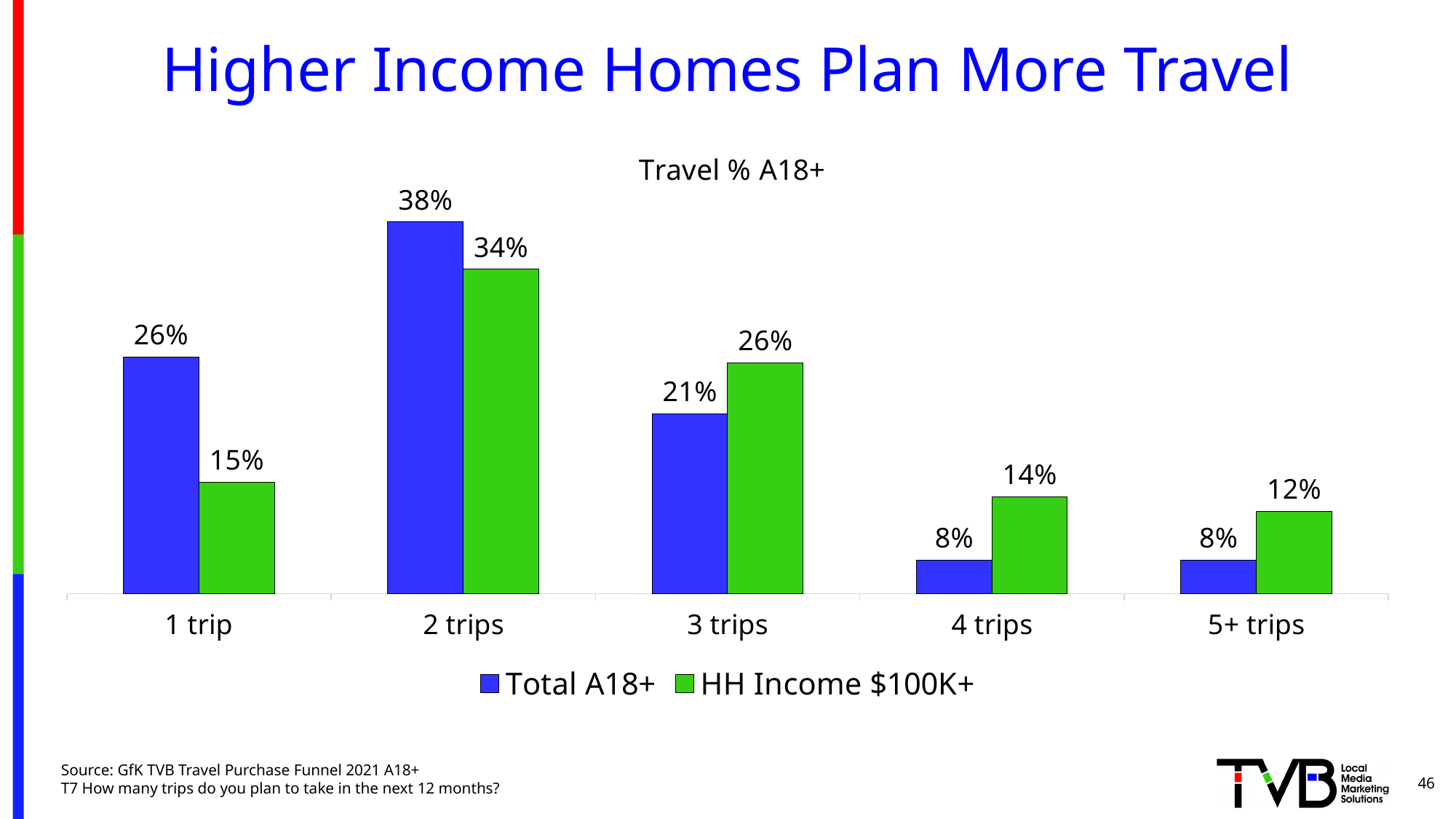
Which colour represents the HH Income $100K+ series? Green How many trip categories are shown on the x axis? 5 How many series does the legend list? 2 What is the title of the chart? Travel % A18+ What is the Total A18+ value for 2 trips? 38% Which category has the highest Total A18+ value? 2 trips What kind of chart is shown on the slide? Bar chart For 3 trips, which series has the larger value, Total A18+ or HH Income $100K+? HH Income $100K+ What is the HH Income $100K+ value for 4 trips? 14% What is the difference between the Total A18+ and HH Income $100K+ values for 1 trip? 11% What is the HH Income $100K+ value for 1 trip? 15% Which category has the lowest HH Income $100K+ value? 5+ trips